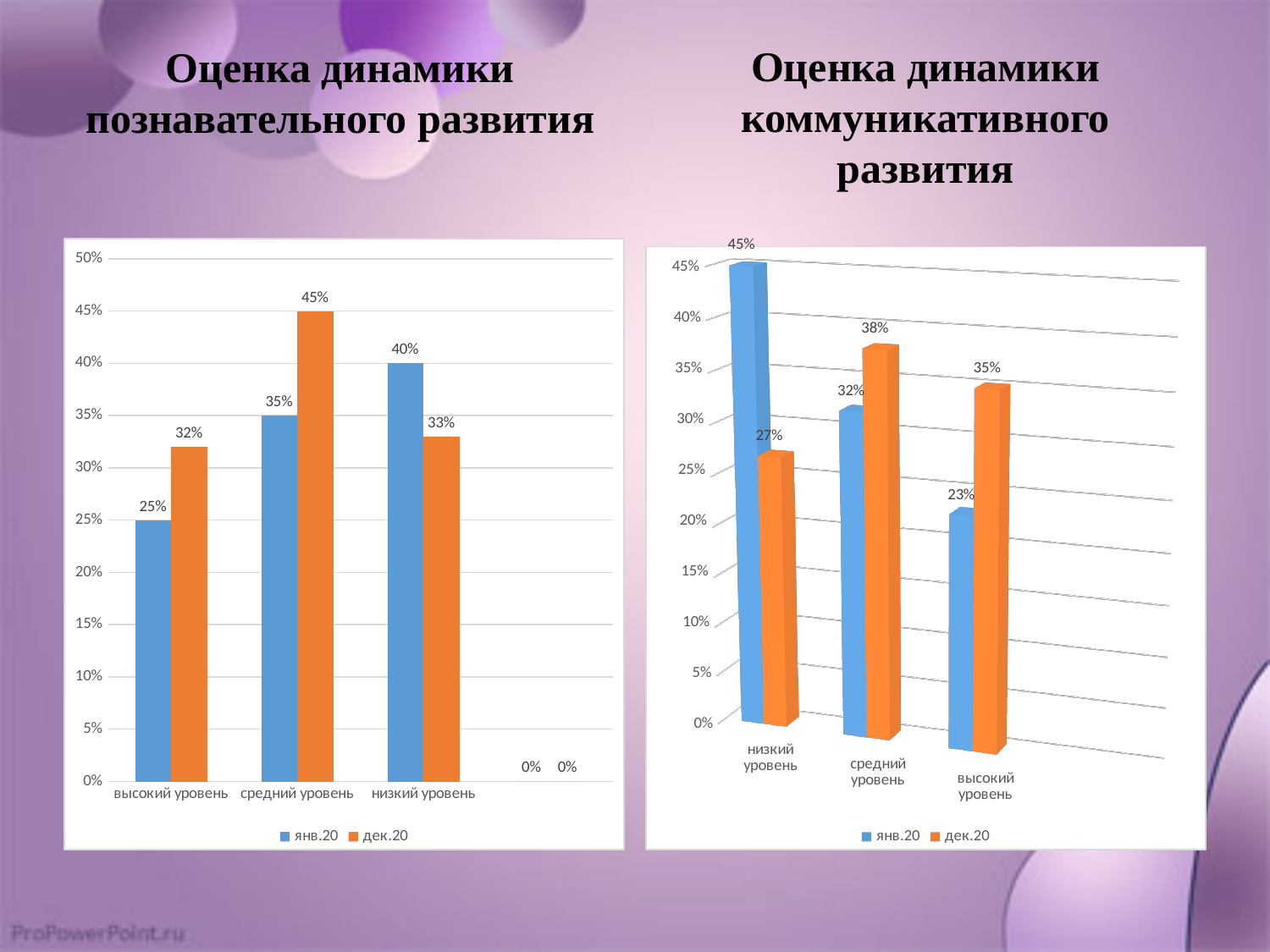
In the right chart (Оценка динамики коммуникативного развития), what is the difference between the янв.20 and дек.20 values for низкий уровень? 18% In the left chart (Оценка динамики познавательного развития), what is the value for высокий уровень in the дек.20 series? 32% In the left chart (Оценка динамики познавательного развития), which is larger for низкий уровень: янв.20 or дек.20? янв.20 In the right chart (Оценка динамики коммуникативного развития), which category has the lowest янв.20 value? высокий уровень In the right chart (Оценка динамики коммуникативного развития), how many categories are shown on the x axis? 3 In the right chart (Оценка динамики коммуникативного развития), what is the value for высокий уровень in the дек.20 series? 35% What kind of chart is the right chart (Оценка динамики коммуникативного развития)? bar chart In the left chart (Оценка динамики познавательного развития), what is the value for низкий уровень in the янв.20 series? 40% In the right chart (Оценка динамики коммуникативного развития), what is the value for низкий уровень in the янв.20 series? 45% In the left chart (Оценка динамики познавательного развития), how many series does the legend list? 2 In the left chart (Оценка динамики познавательного развития), what is the difference between the дек.20 and янв.20 values for средний уровень? 10% In the left chart (Оценка динамики познавательного развития), which category has the highest дек.20 value? средний уровень